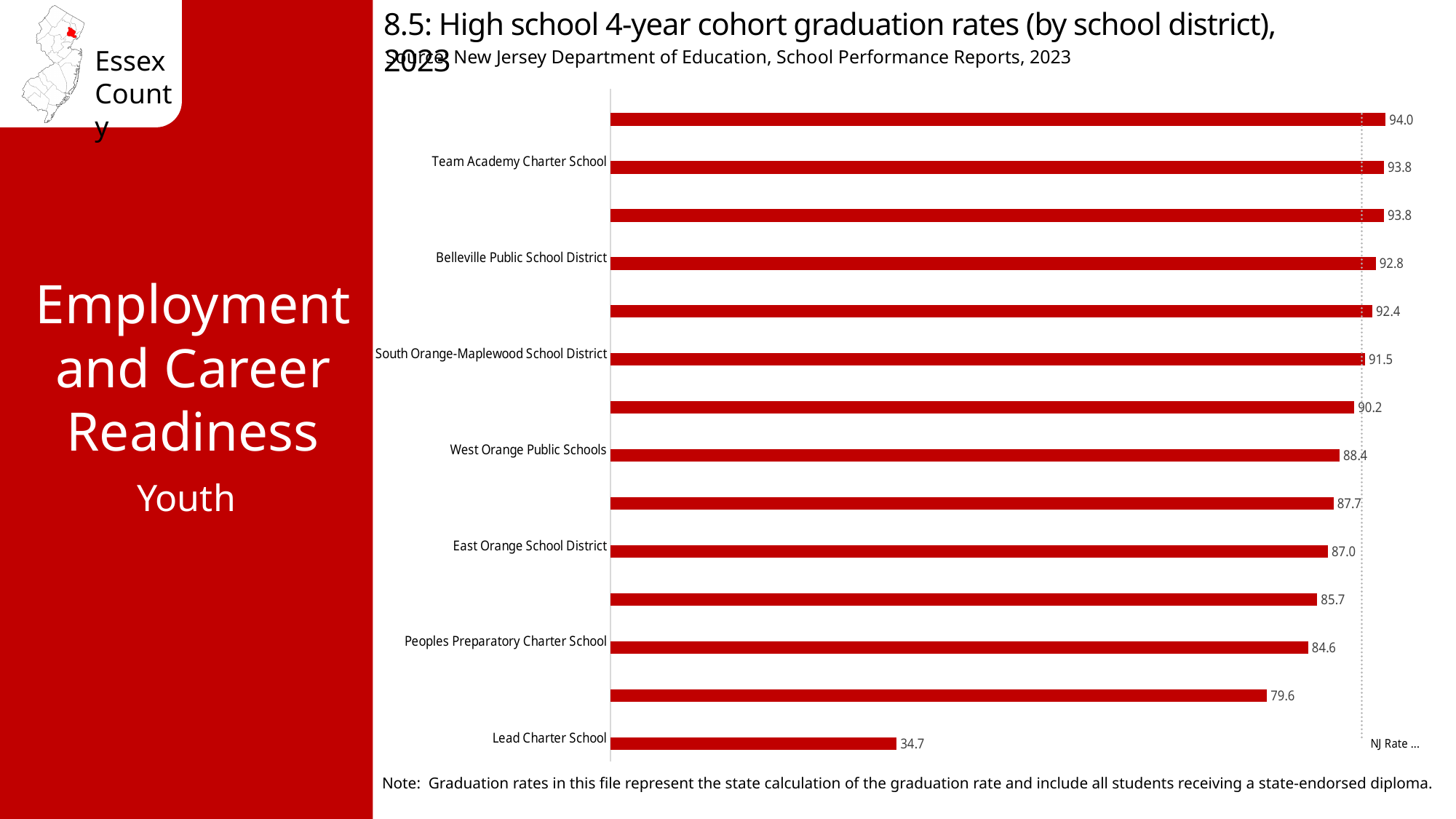
Which has a higher graduation rate, Belleville Public School District or West Orange Public Schools? Belleville Public School District What is the graduation rate for Team Academy Charter School? 93.8 How many bars are plotted on the chart? 14 What is the graduation rate for West Orange Public Schools? 88.4 What is the graduation rate for Belleville Public School District? 92.8 What is the graduation rate for Lead Charter School? 34.7 Which labeled district has the lowest graduation rate? Lead Charter School What is the graduation rate for South Orange-Maplewood School District? 91.5 What is the difference between the graduation rates of East Orange School District and Peoples Preparatory Charter School? 2.4 What type of chart is shown on the slide? Bar chart What does the dotted vertical line on the chart represent? NJ Rate What is the highest graduation rate value shown on the chart? 94.0